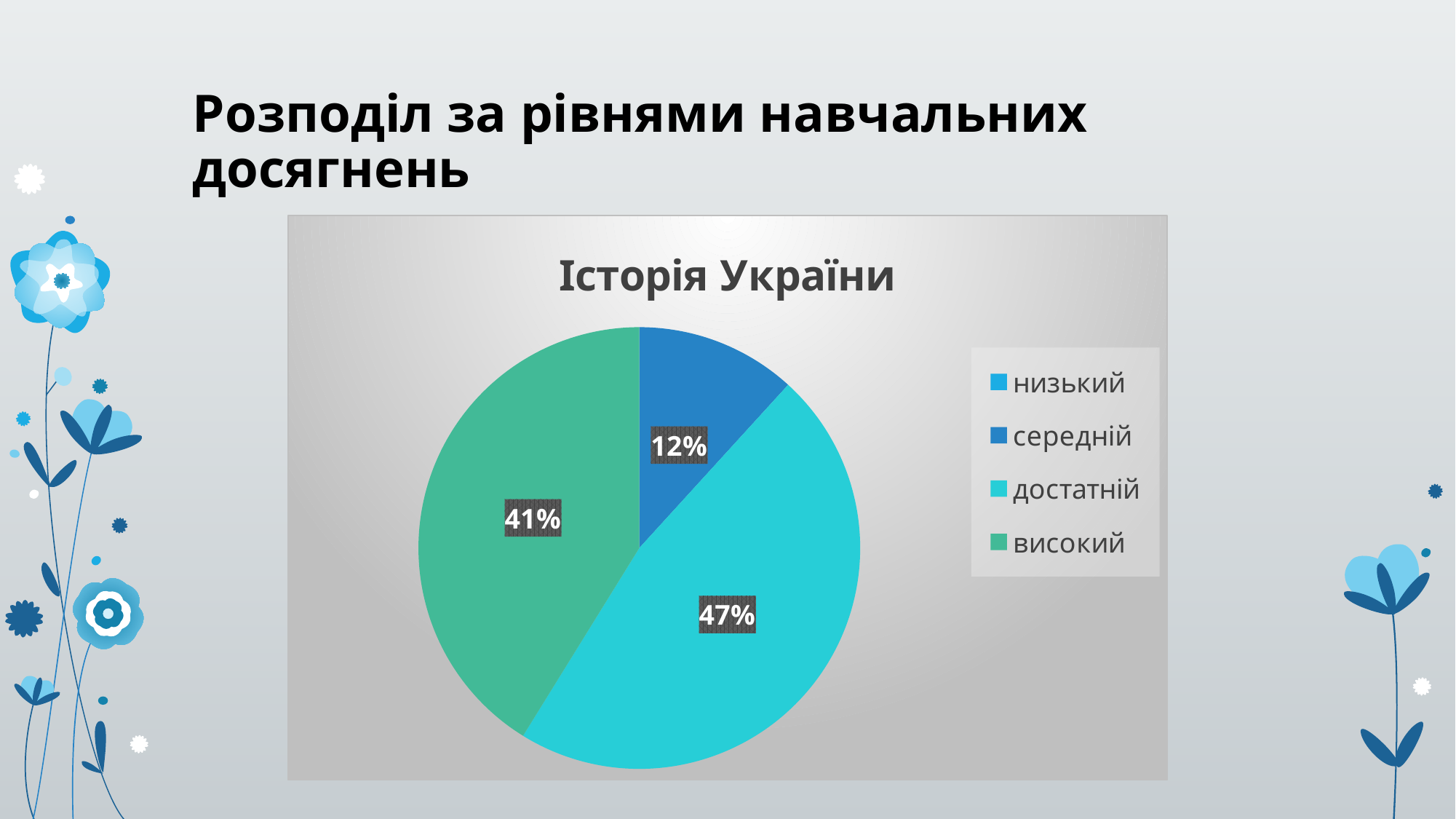
What kind of chart is shown on the slide? pie chart What share of the pie does the "достатній" slice represent? 47% What is the difference in percentage points between "достатній" and "високий"? 6 What is the value shown for "високий"? 41% What is the value shown for "середній"? 12% Which legend entry is shown in green? високий What is the title of the chart? Історія України Which category has the largest slice of the pie? достатній How many entries does the chart legend list? 4 Which is larger, the slice for "достатній" or the slice for "високий"? достатній What is the difference in percentage points between "високий" and "середній"? 29 Which of the labelled slices is the smallest? середній